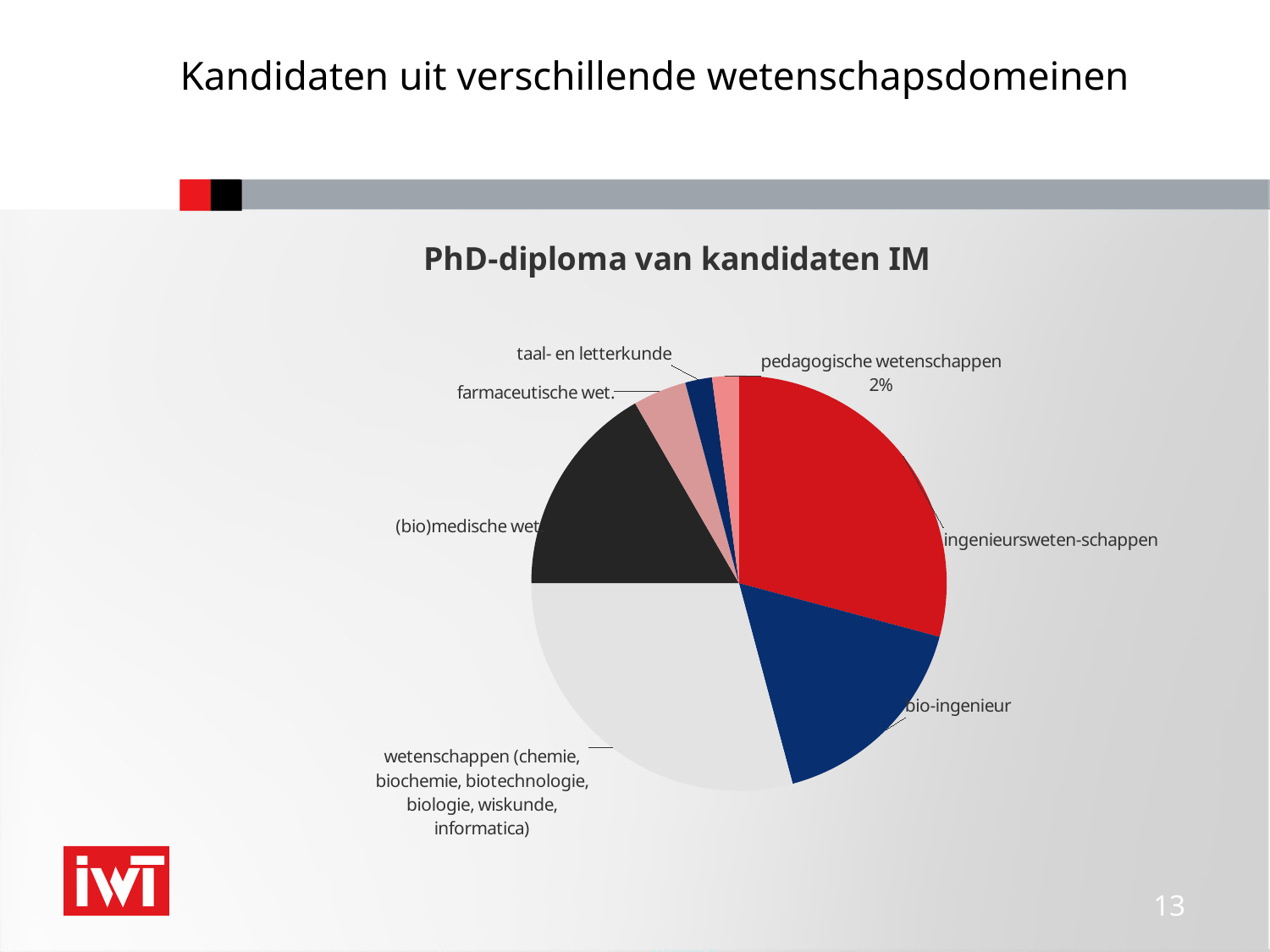
What share of the pie does pedagogische wetenschappen have? 2% How many slices does the pie chart have? 7 Which slice is larger: wetenschappen (chemie, biochemie, biotechnologie, biologie, wiskunde, informatica) or farmaceutische wet.? wetenschappen (chemie, biochemie, biotechnologie, biologie, wiskunde, informatica) Which slice is larger: bio-ingenieur or pedagogische wetenschappen? bio-ingenieur Is the share for pedagogische wetenschappen greater or less than 10%? less What is the title of the chart? PhD-diploma van kandidaten IM Which slice is larger: ingenieurswetenschappen or bio-ingenieur? ingenieurswetenschappen What kind of chart is shown on the slide? pie chart What colour is the ingenieurswetenschappen slice? red